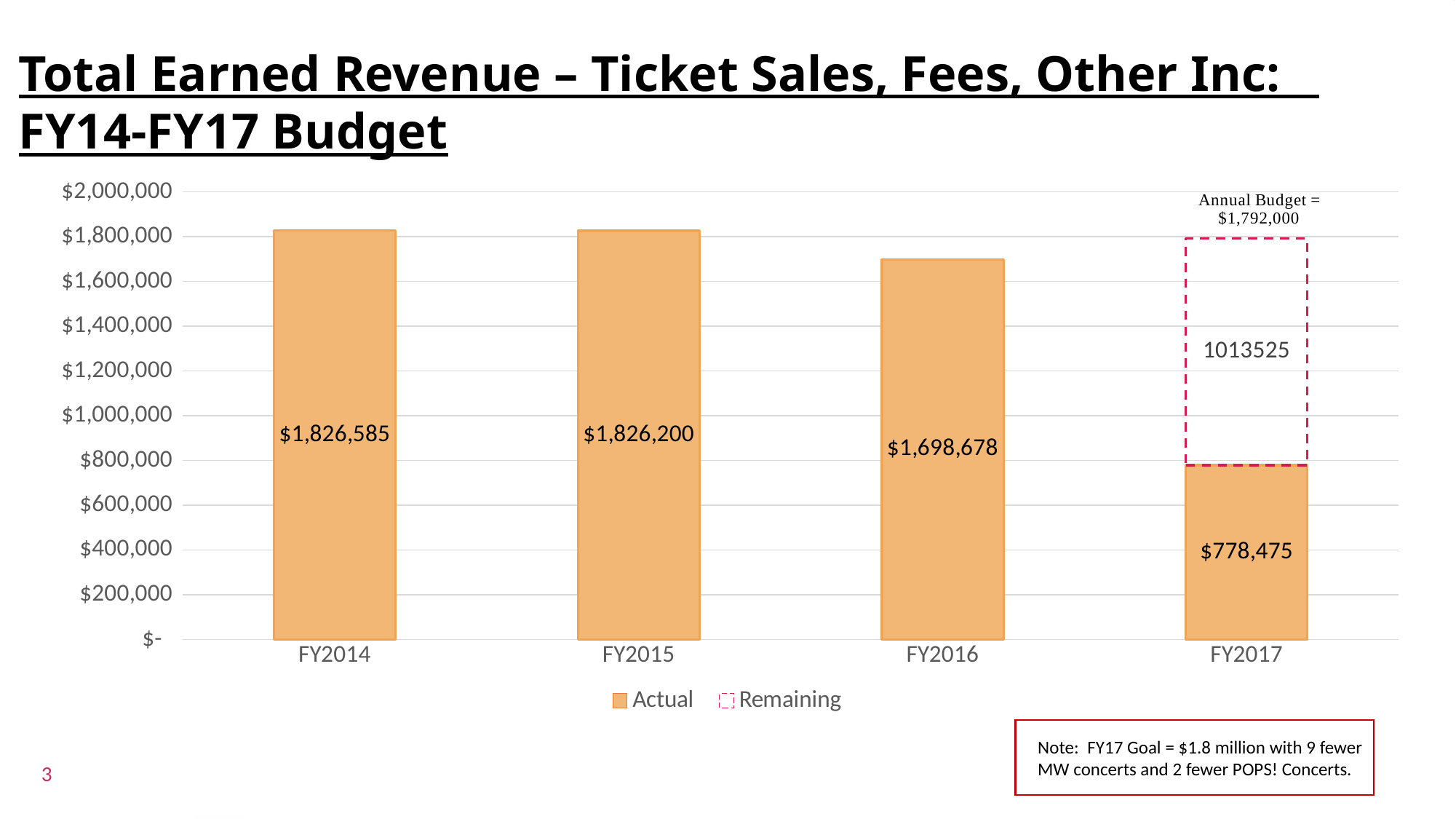
What is the Remaining value shown for FY2017? 1013525 What is the Actual value for FY2016? $1,698,678 Is the Actual value for FY2016 greater or less than $1,800,000? less Which is larger, the Actual value for FY2015 or for FY2016? FY2015 What is the Actual value for FY2017? $778,475 How many series does the legend list? 2 How many fiscal years are shown on the x axis? 4 Which fiscal year has the lowest Actual value? FY2017 What is the difference between the Actual values for FY2016 and FY2017? $920,203 What is the Actual value for FY2014? $1,826,585 What is the difference between the Actual values for FY2014 and FY2016? $127,907 What is the total of the stacked bar for FY2017 (Actual plus Remaining)? $1,792,000